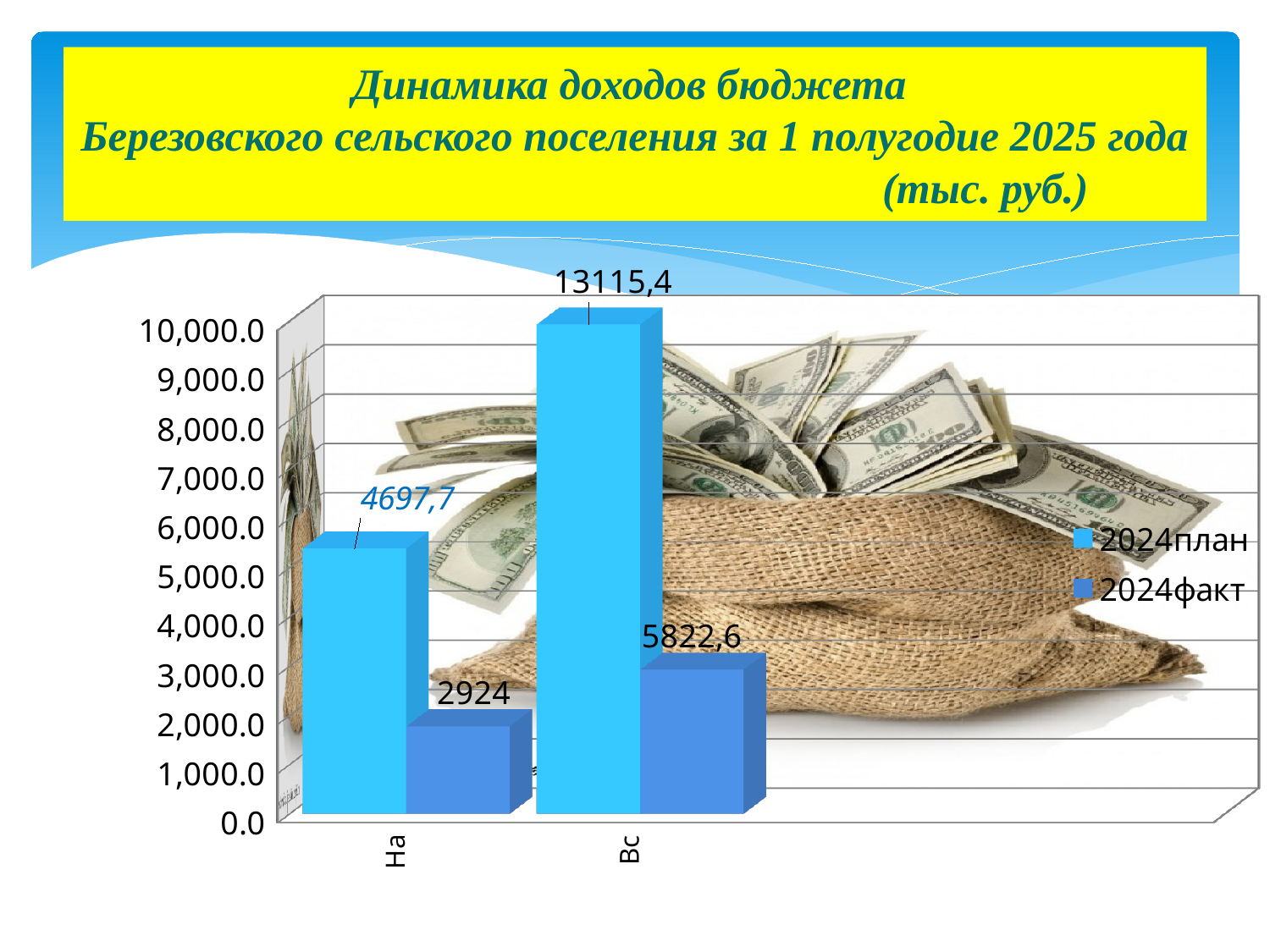
Which bar has the highest labelled value on the chart? 2024план in the right group (13115,4) What is the data label on the 2024план bar in the right group of bars? 13115,4 What is the difference between the 2024план and 2024факт labels in the right group of bars? 7292,8 How many groups of bars (categories) are shown on the x axis? 2 What is the data label on the 2024факт bar in the right group of bars? 5822,6 How many series does the chart legend list? 2 What is the data label on the 2024факт bar in the left group of bars? 2924 What kind of chart is shown on the slide? Bar chart What are the two series named in the chart legend? 2024план and 2024факт In the right group of bars, which is larger: 2024план or 2024факт? 2024план What is the data label on the 2024план bar in the left group of bars? 4697,7 Which bar has the lowest labelled value on the chart? 2024факт in the left group (2924)